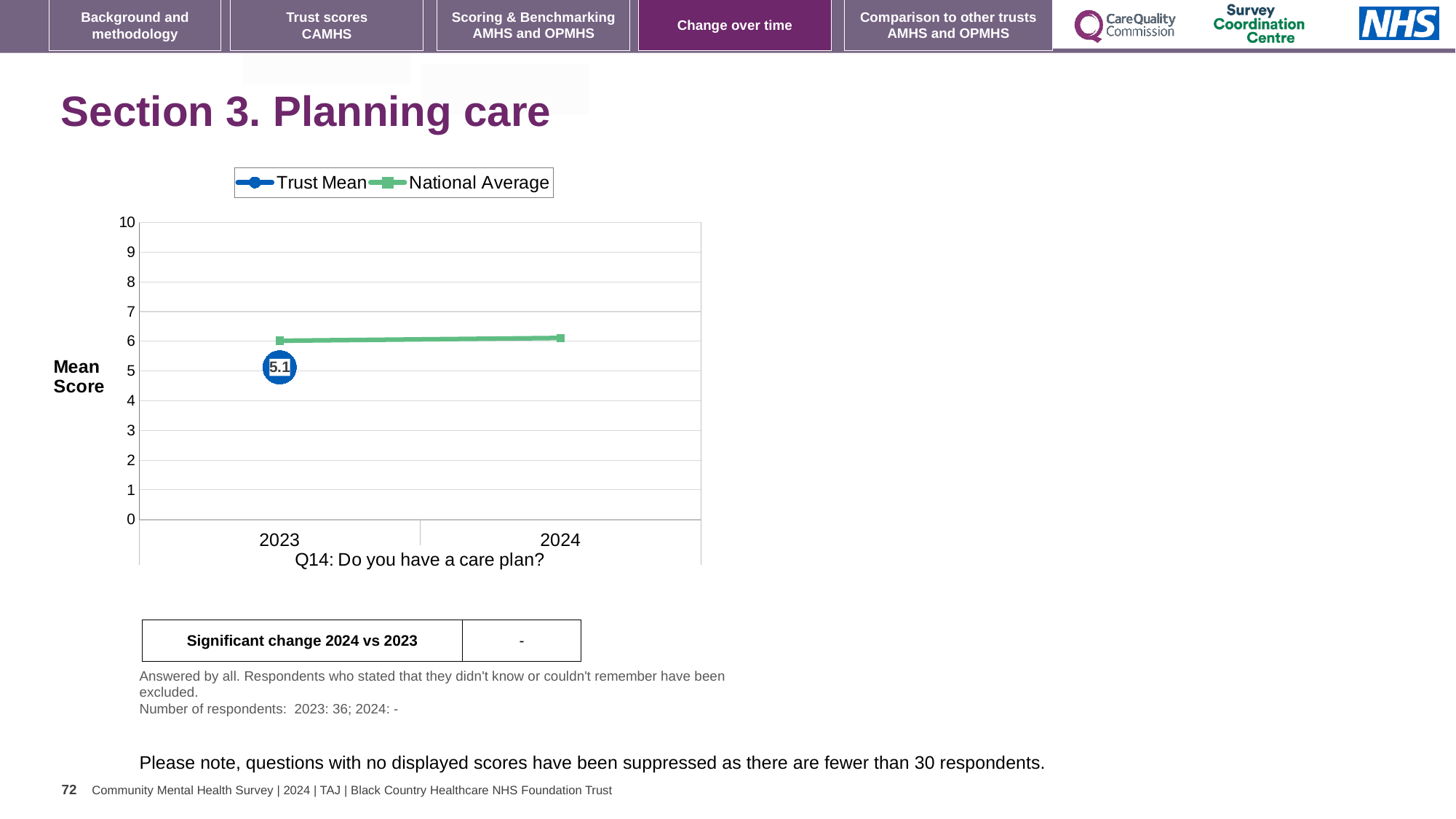
Is a Trust Mean value plotted for 2024? No What is the Trust Mean value for 2023? 5.1 Is the National Average value for 2023 greater or less than 7? less What are the two series named in the legend? Trust Mean and National Average Is the Trust Mean value for 2023 greater or less than 6? less Does the National Average rise or fall from 2023 to 2024? rises What kind of chart is shown on the slide? Line chart How many years are shown on the x axis? 2 Is the National Average value for 2024 greater or less than 5? greater What is the label on the y axis of the chart? Mean Score How many series does the legend list? 2 In 2023, which is higher: the Trust Mean or the National Average? National Average